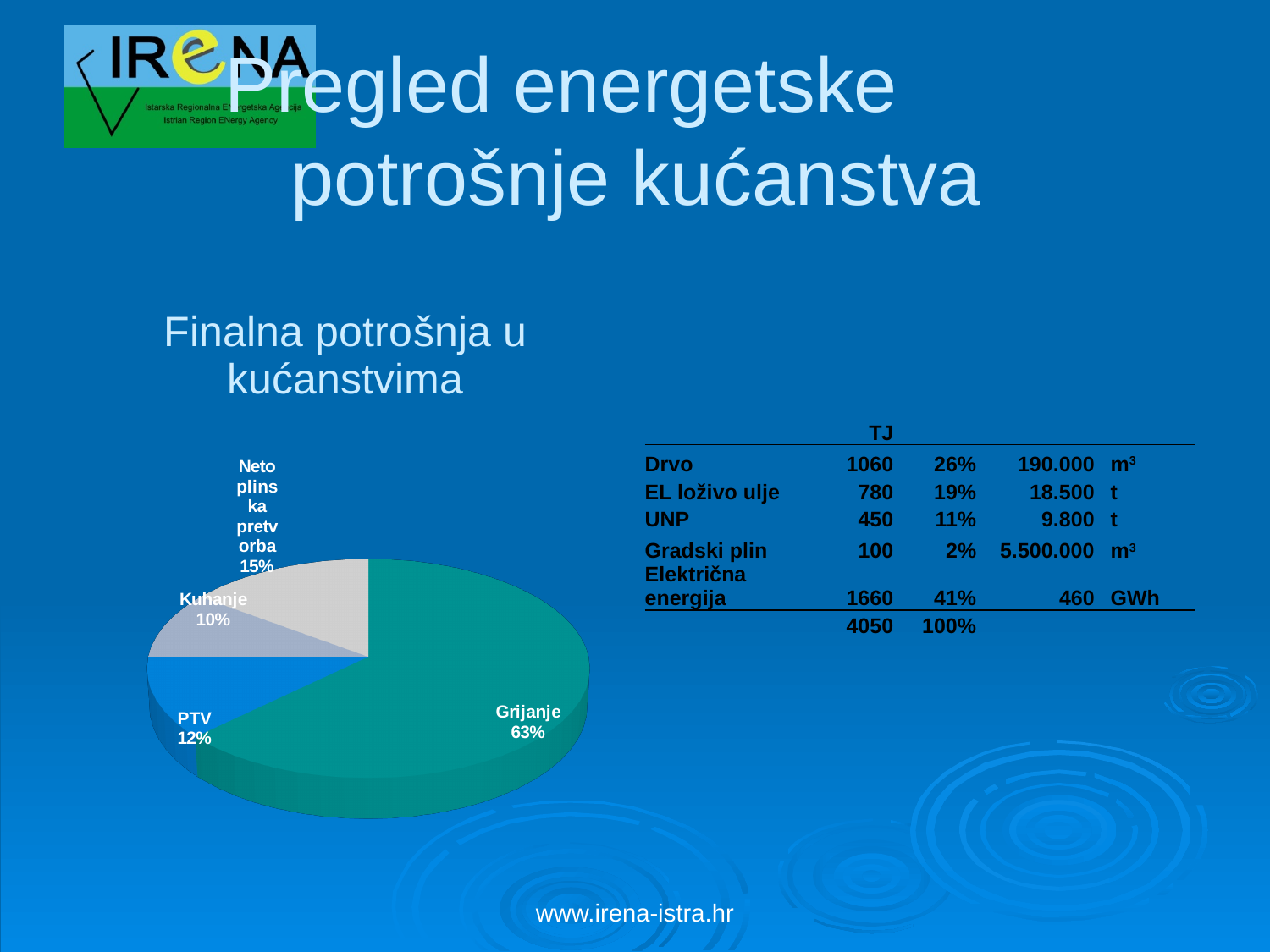
What kind of chart is shown on the slide? pie chart What share of the pie does Kuhanje have? 10% How many slices does the pie chart have? 4 What share of the pie does PTV have? 12% What is the title shown above the pie chart? Finalna potrošnja u kućanstvima What share of the pie does Neto plinska pretvorba have? 15% What share of the pie does Grijanje have? 63% Which is larger, the share for Neto plinska pretvorba or the share for Kuhanje? Neto plinska pretvorba What is the difference in percentage points between Grijanje and PTV? 51 Which slice of the pie chart is the smallest? Kuhanje Which slice of the pie chart is the largest? Grijanje What is the difference in percentage points between Neto plinska pretvorba and PTV? 3